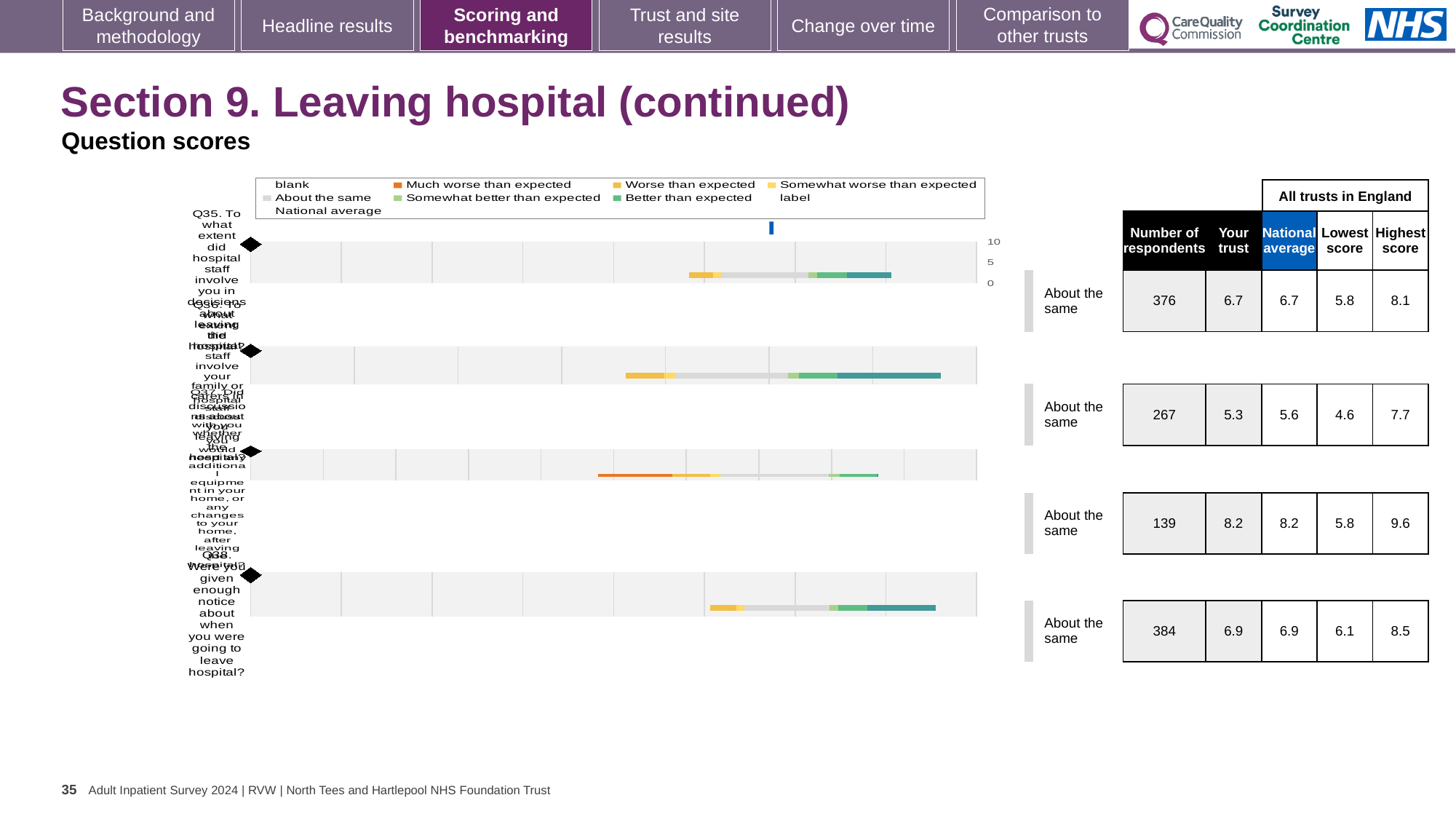
What is the difference between the highest score and the lowest score across all trusts in England for Q36? 3.1 What is the highest score across all trusts in England shown for Q37? 9.6 What is the national average score shown for Q37? 8.2 How many respondents are shown for Q38? 384 What kind of chart is used to show the benchmarking results for each question on this slide? bar chart How many questions (Q35 to Q38) have a benchmarking bar chart on this slide? 4 Which question (Q35 to Q38) has the lowest 'Your trust' score? Q36 What is the 'Your trust' score shown for Q35? 6.7 What benchmark category is shown next to the Q38 chart? About the same For Q36, which is larger: the 'Your trust' score or the national average? National average What is the 'Your trust' score shown for Q36? 5.3 Which question (Q35 to Q38) has the highest 'Your trust' score? Q37